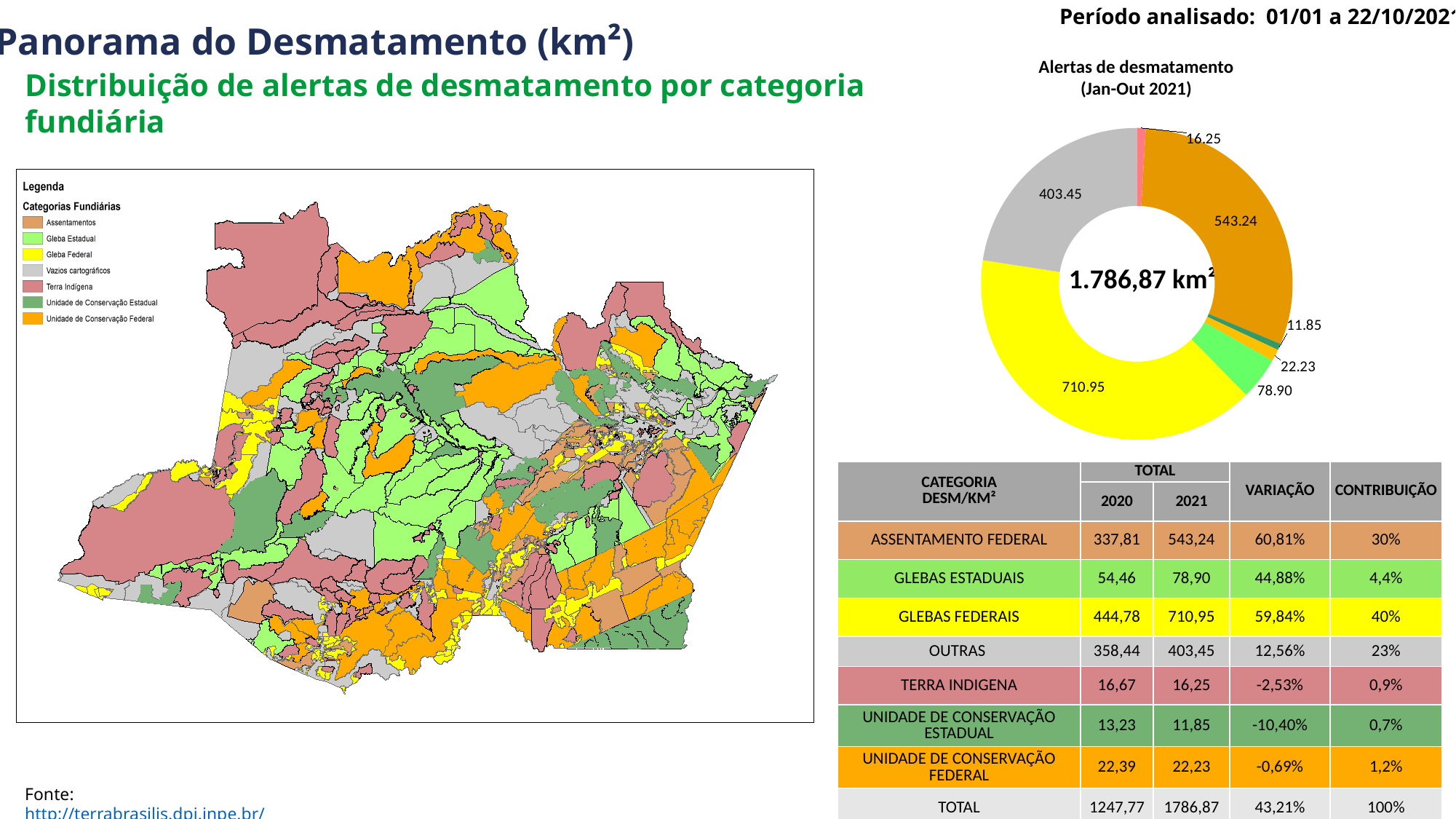
In the 'Alertas de desmatamento (Jan-Out 2021)' chart, what value is labelled on the grey slice (Outras)? 403.45 In the 'Alertas de desmatamento (Jan-Out 2021)' chart, what is the difference between the light green slice (78.90) and the slice labelled 22.23? 56.67 According to the table, what share (contribuição) of the total do Glebas Federais represent? 40% In the 'Alertas de desmatamento (Jan-Out 2021)' chart, which is larger: the grey slice (403.45) or the orange slice (543.24)? 543.24 (orange slice) What kind of chart is 'Alertas de desmatamento (Jan-Out 2021)'? Donut (pie) chart In the 'Alertas de desmatamento (Jan-Out 2021)' chart, what is the value of the smallest slice? 11.85 In the 'Alertas de desmatamento (Jan-Out 2021)' chart, what is the value of the largest slice? 710.95 How many slices does the 'Alertas de desmatamento (Jan-Out 2021)' donut chart have? 7 What is the title of the donut chart on the slide? Alertas de desmatamento (Jan-Out 2021) In the 'Alertas de desmatamento (Jan-Out 2021)' chart, what is the difference between the two largest slices (710.95 and 543.24)? 167.71 What total is shown in the centre of the 'Alertas de desmatamento (Jan-Out 2021)' donut chart? 1.786,87 km² In the 'Alertas de desmatamento (Jan-Out 2021)' chart, what value is labelled on the yellow slice (Glebas Federais)? 710.95